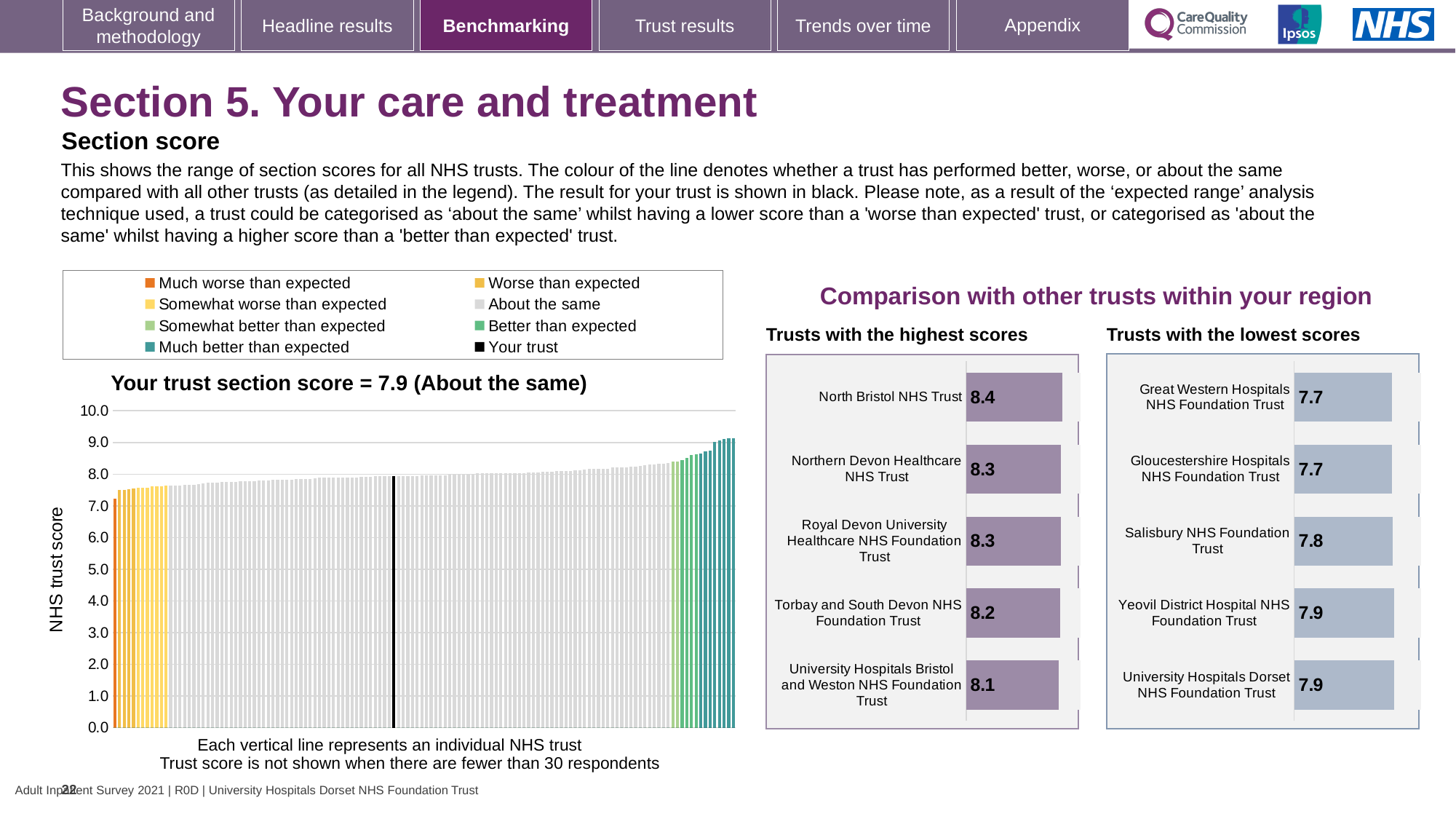
How many trusts are shown in the 'Trusts with the highest scores' chart? 5 What kind of chart is the 'Your trust section score' chart on the left? Bar chart In the 'Trusts with the lowest scores' chart, which trust has the highest score, Yeovil District Hospital NHS Foundation Trust or Great Western Hospitals NHS Foundation Trust? Yeovil District Hospital NHS Foundation Trust In the 'Your trust section score' chart on the left, what is the section score for your trust? 7.9 In the 'Trusts with the highest scores' chart, what is the score for North Bristol NHS Trust? 8.4 In the 'Trusts with the highest scores' chart, which trust has the highest score? North Bristol NHS Trust How many entries does the legend of the 'Your trust section score' chart list? 8 How many trusts are shown in the 'Trusts with the lowest scores' chart? 5 In the 'Trusts with the lowest scores' chart, what is the difference between the scores of Salisbury NHS Foundation Trust and Gloucestershire Hospitals NHS Foundation Trust? 0.1 In the 'Trusts with the highest scores' chart, what is the difference between the scores of North Bristol NHS Trust and University Hospitals Bristol and Weston NHS Foundation Trust? 0.3 In the 'Your trust section score' chart on the left, is the value of the lowest-scoring trust greater or less than 8.0? less In the 'Trusts with the lowest scores' chart, what is the score for Salisbury NHS Foundation Trust? 7.8